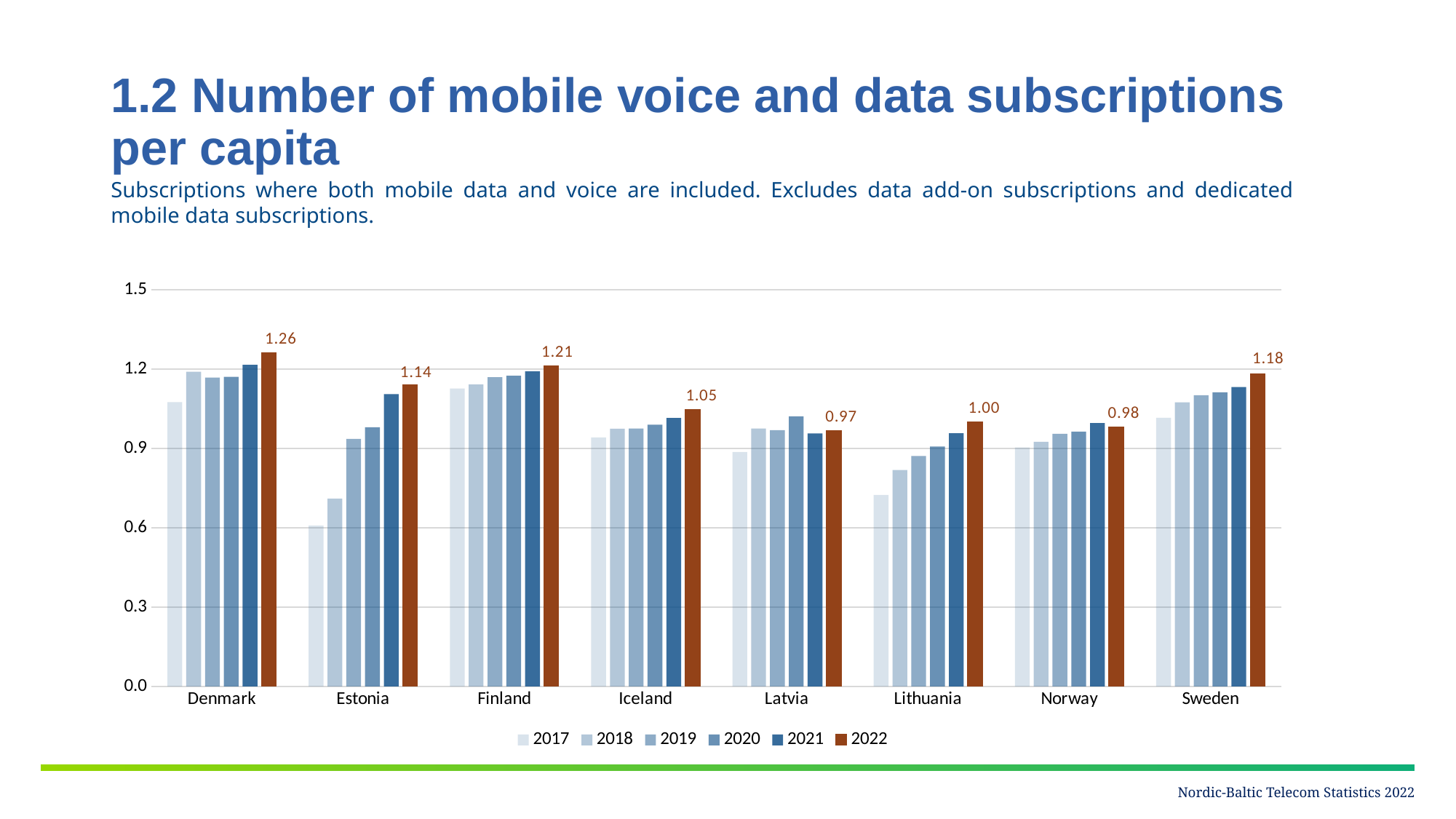
Which country has the lowest 2022 value? Latvia How many series does the legend list? 6 What is the 2022 value for Latvia? 0.97 What is the 2022 value for Denmark? 1.26 How many countries are shown on the x axis? 8 Which is larger, the 2022 value for Estonia or the 2022 value for Sweden? Sweden What is the 2022 value for Sweden? 1.18 What is the difference between the 2022 values for Finland and Iceland? 0.16 What kind of chart is shown? bar chart Do the values for Estonia rise or fall from 2017 to 2022? rise Which country has the highest 2022 value? Denmark Is the 2017 value for Estonia greater or less than 0.9? less